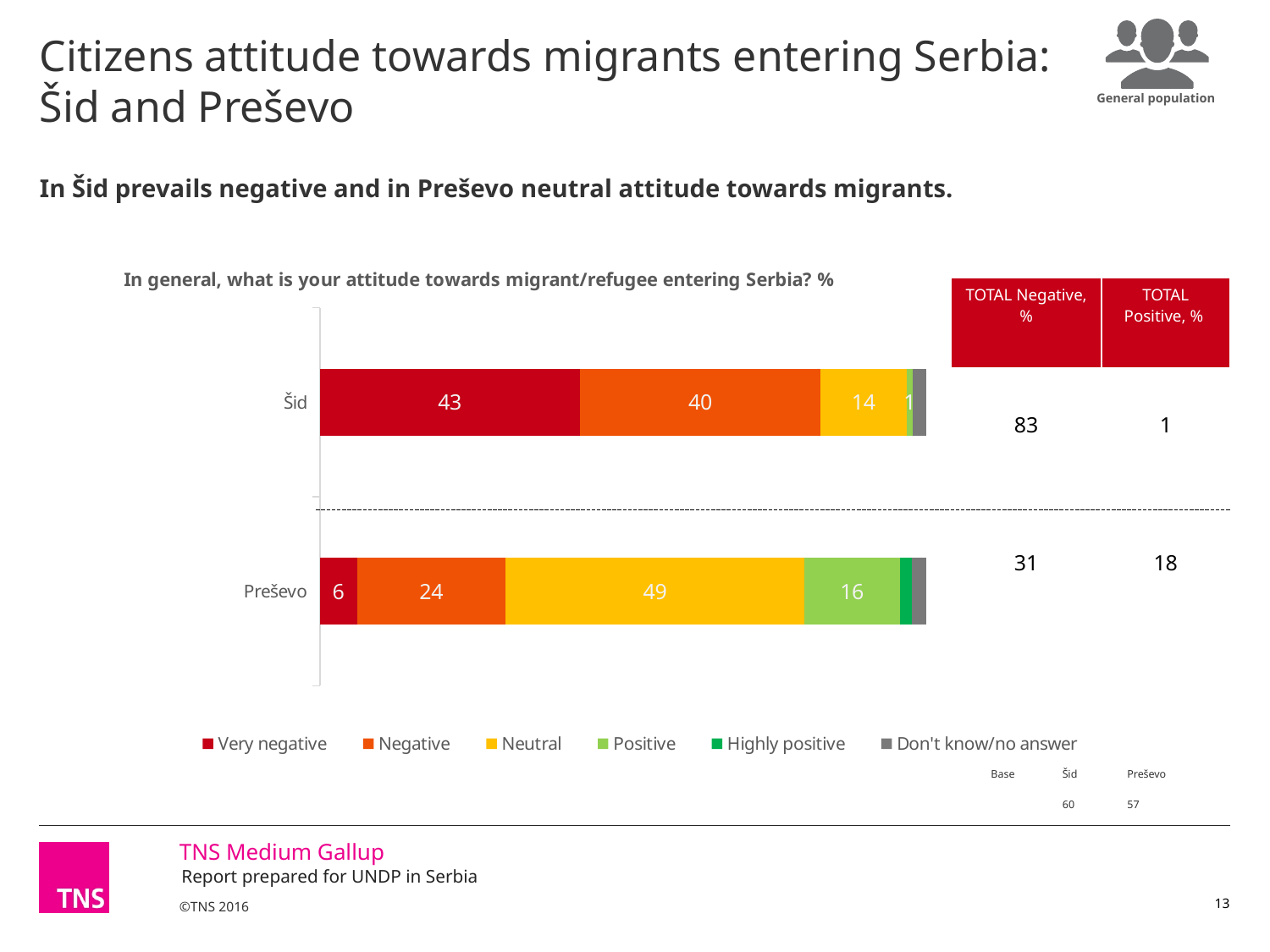
What is the Neutral value for Preševo? 49 How many categories (bars) are shown in the chart? 2 What is the Positive value for Preševo? 16 How many series does the legend list? 6 What is the Very negative value for Preševo? 6 What kind of chart is shown on the slide? Stacked bar chart What is the Very negative value for Šid? 43 What is the difference between the Very negative values for Šid and Preševo? 37 Which series is the largest segment in the Šid bar? Very negative What is the difference between the Neutral values for Preševo and Šid? 35 Which category has the higher Neutral value, Šid or Preševo? Preševo What is the Negative value for Šid? 40